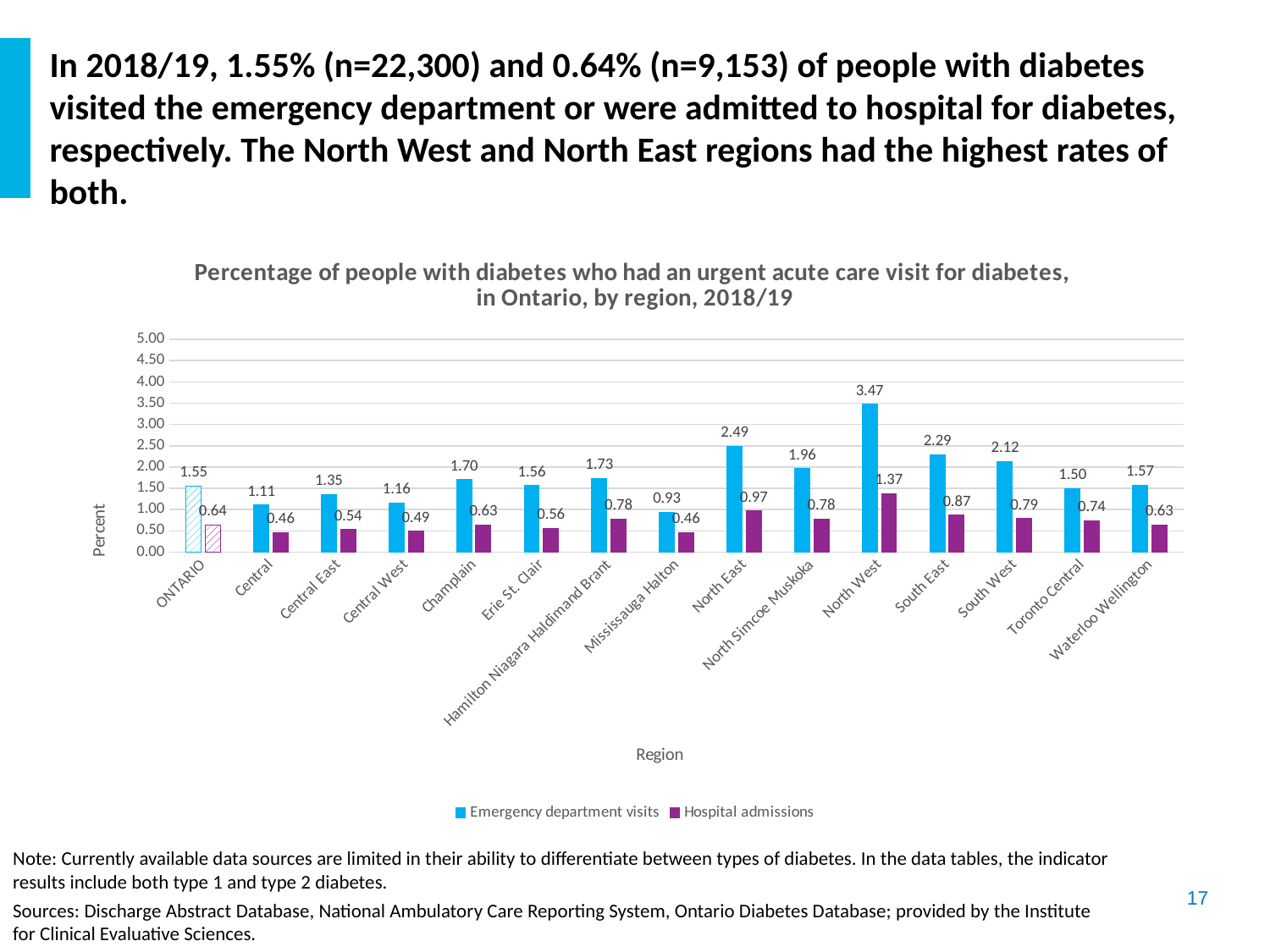
Which is larger: the Hospital admissions value for South East or for Toronto Central? South East How many series does the legend list? 2 What is the label of the y axis of the chart? Percent Which region has the highest value for Emergency department visits? North West What kind of chart is shown on the slide? Bar chart How many categories are shown on the x axis of the chart? 15 What is the value for Emergency department visits in the North West region? 3.47 What is the value for Hospital admissions in the Central East region? 0.54 What is the Hospital admissions value for ONTARIO? 0.64 What is the difference between the Emergency department visits values for North West and North East? 0.98 Is the Emergency department visits value for South West greater or less than 2.00? greater Which region has the lowest value for Emergency department visits? Mississauga Halton